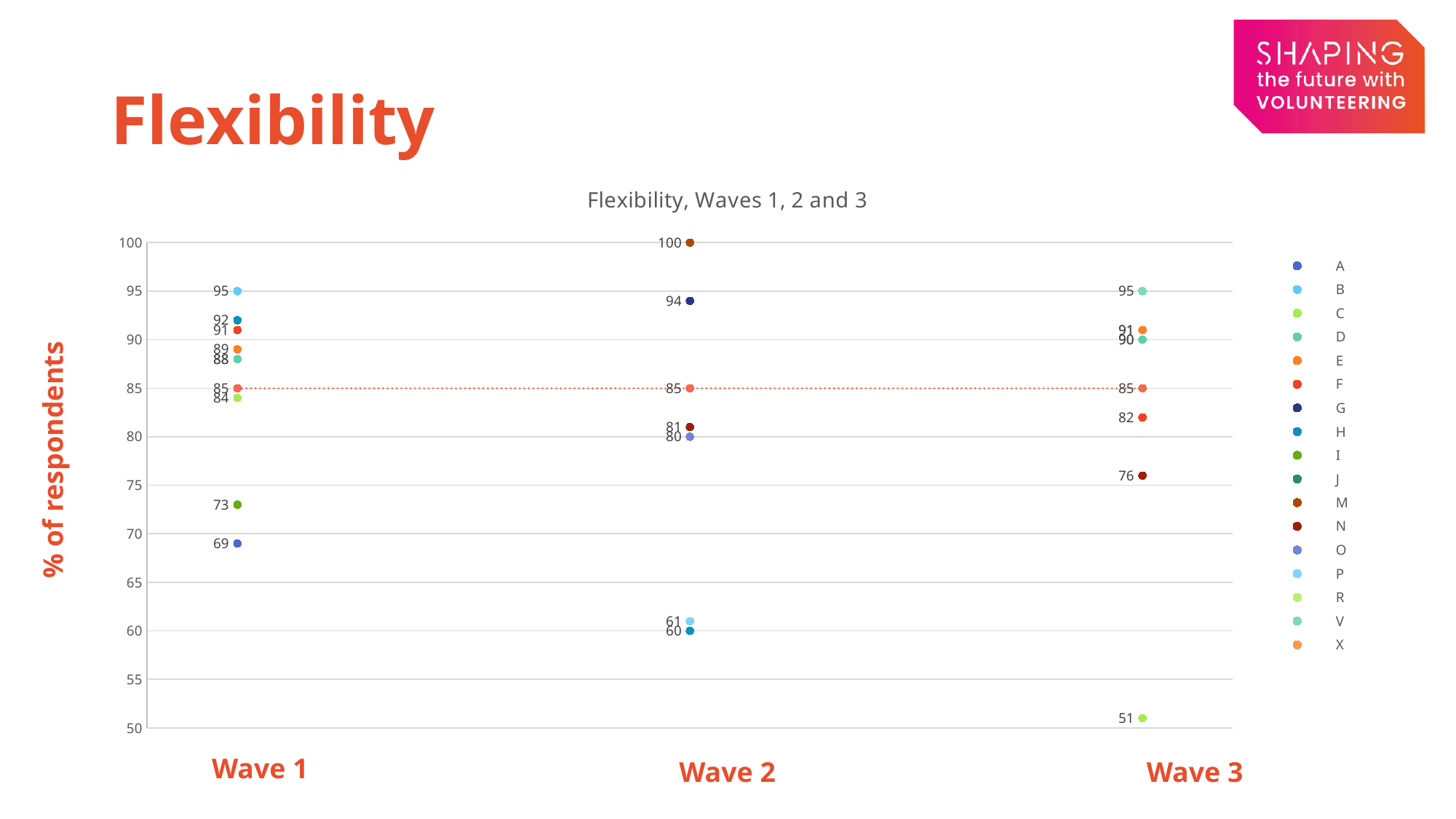
What is the highest value plotted for Wave 1? 95 What kind of chart is shown on the slide? Scatter (dot) chart What is the label on the vertical axis of the chart? % of respondents What is the highest value plotted for Wave 2? 100 What is the lowest value plotted for Wave 3? 51 What is the title of the chart? Flexibility, Waves 1, 2 and 3 How many series does the legend list? 17 What is the lowest value plotted for Wave 1? 69 Which wave has the higher maximum value, Wave 2 or Wave 3? Wave 2 What is the lowest value plotted for Wave 2? 60 What is the difference between the highest and lowest values plotted for Wave 2? 40 How many waves (categories) are shown along the x axis? 3